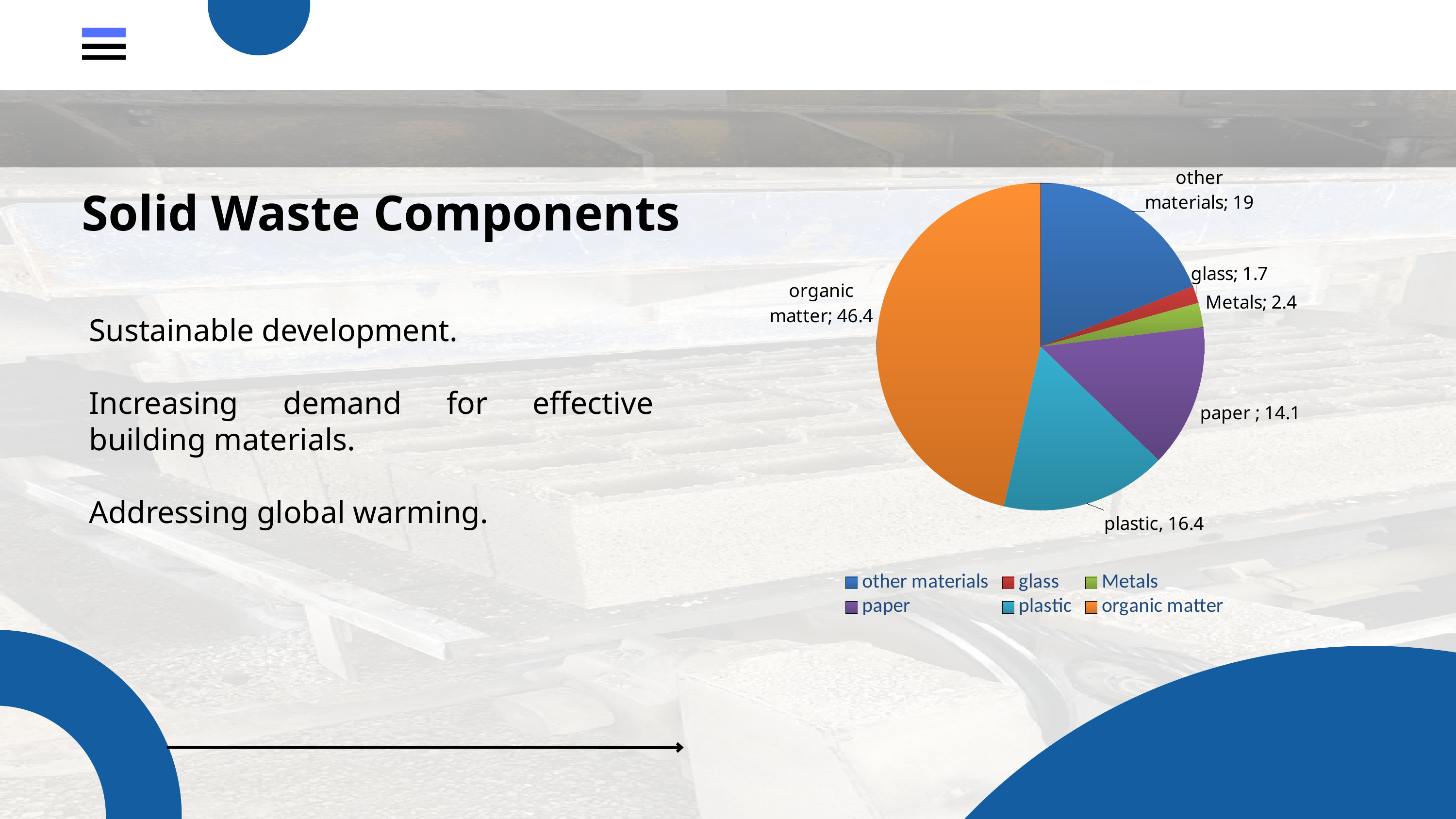
What is the value for organic matter in the pie chart? 46.4 How many categories does the pie chart show? 6 What is the difference between the values for organic matter and other materials? 27.4 What is the value for paper in the pie chart? 14.1 Which is larger, the value for plastic or the value for paper? plastic What is the value for glass in the pie chart? 1.7 What is the value for other materials in the pie chart? 19 What is the value for plastic in the pie chart? 16.4 Which category has the largest slice in the pie chart? organic matter What colour is the organic matter slice in the pie chart? orange Which category has the smallest slice in the pie chart? glass What type of chart is shown on the slide? pie chart